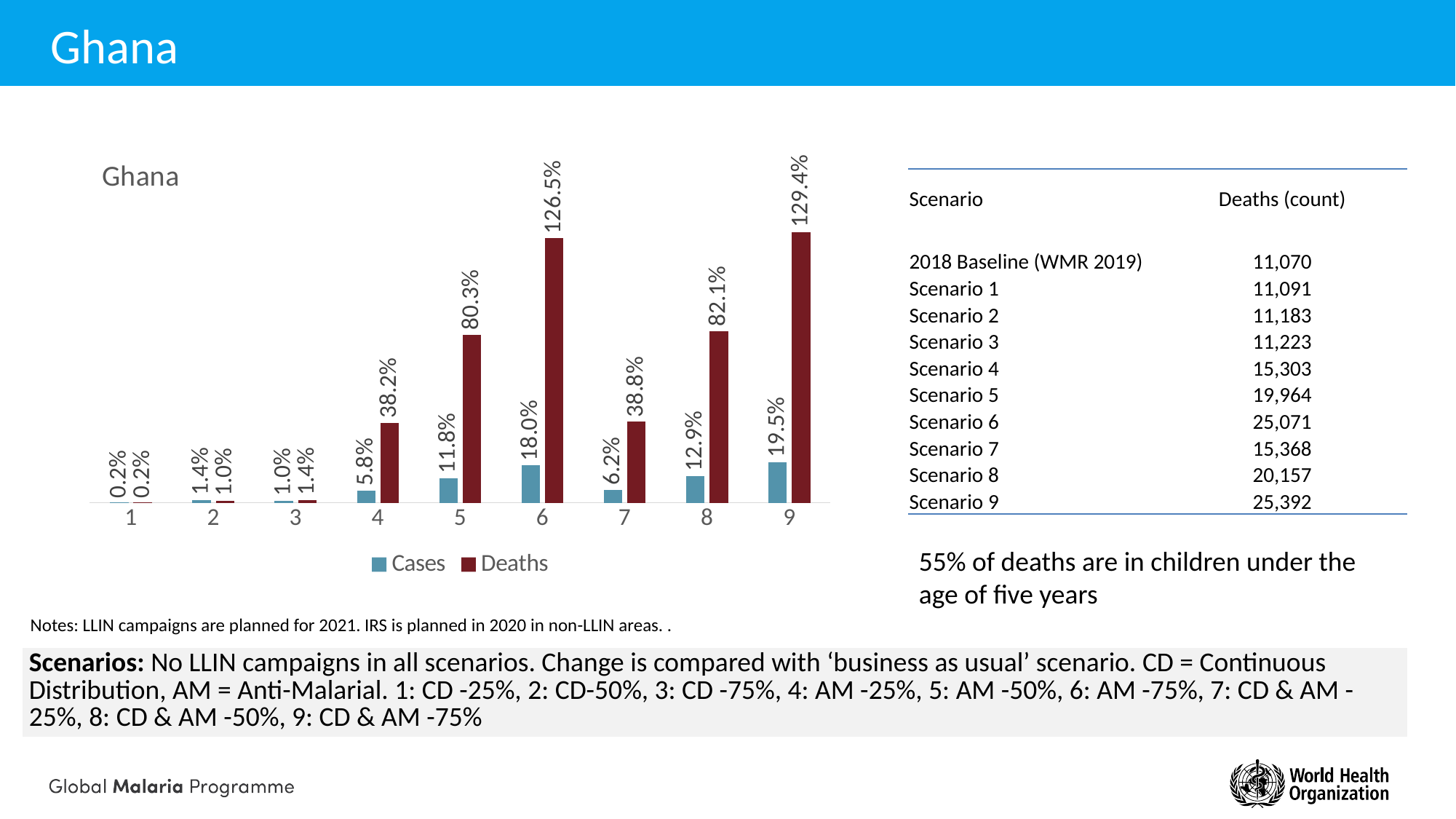
What kind of chart is shown on the slide? Bar chart Which scenario has the highest Deaths value? 9 What is the difference between the Deaths and Cases values for scenario 4? 32.4% Which scenario has the lowest Cases value? 1 How many series does the chart legend list? 2 Which is larger, the Deaths value for scenario 5 or for scenario 8? Scenario 8 What is the Cases value for scenario 5? 11.8% What is the difference between the Deaths values for scenario 9 and scenario 6? 2.9% What is the Deaths value for scenario 6? 126.5% Which series is shown in dark red in the chart? Deaths How many scenarios are shown on the x axis of the chart? 9 What is the Cases value for scenario 9? 19.5%